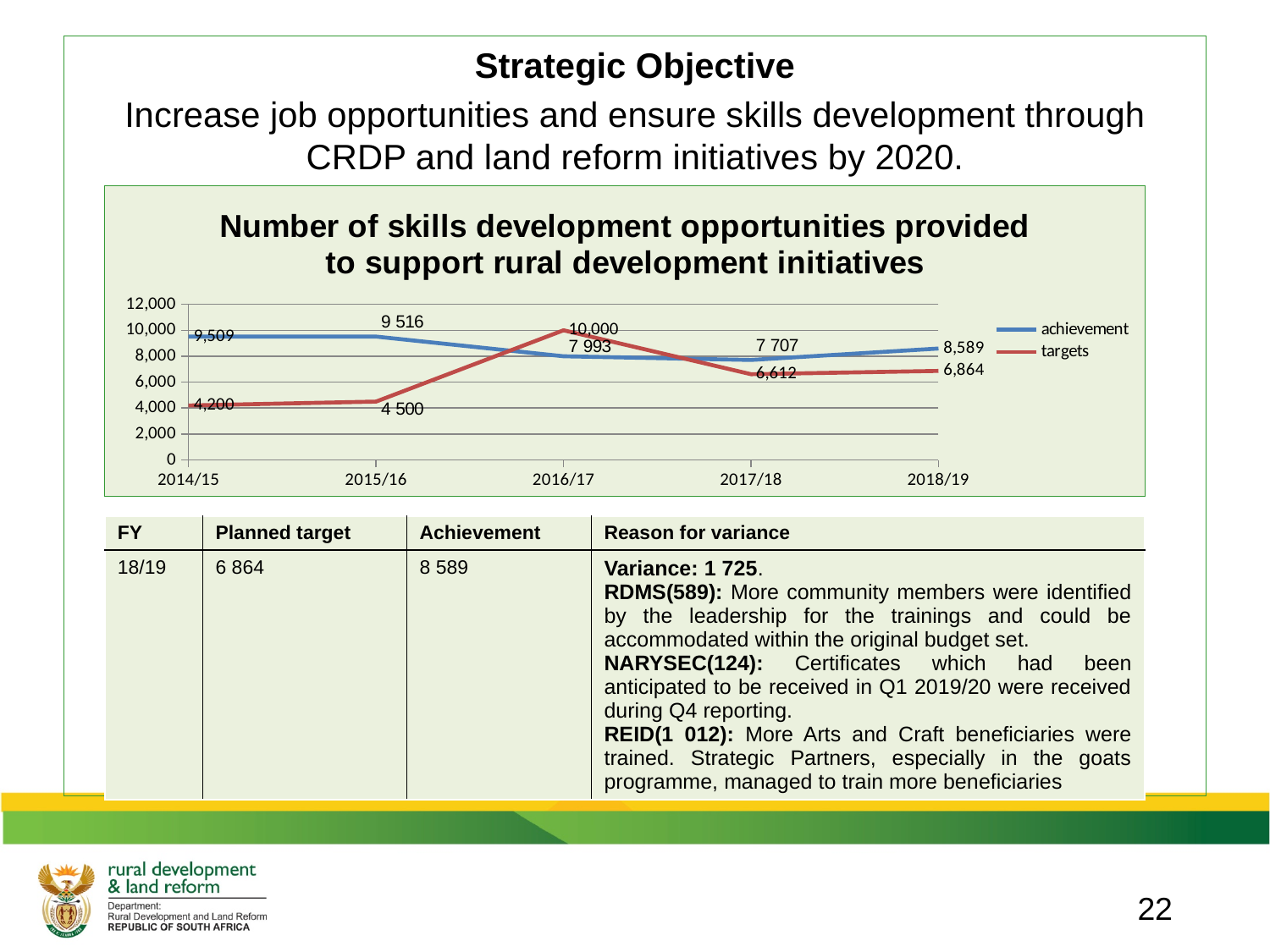
In which financial year is the achievement value lowest? 2017/18 In which financial year is the targets value highest? 2016/17 Does the targets line rise or fall from 2014/15 to 2016/17? Rise How many financial years are plotted on the x axis? 5 What is the achievement value for 2018/19? 8,589 What type of chart is shown on the slide? Line chart What is the achievement value for 2017/18? 7 707 In 2016/17, which is larger: achievement or targets? targets What is the targets value for 2014/15? 4,200 How many series does the chart legend list? 2 What is the difference between the achievement and targets values in 2018/19? 1,725 What is the targets value for 2016/17? 10,000